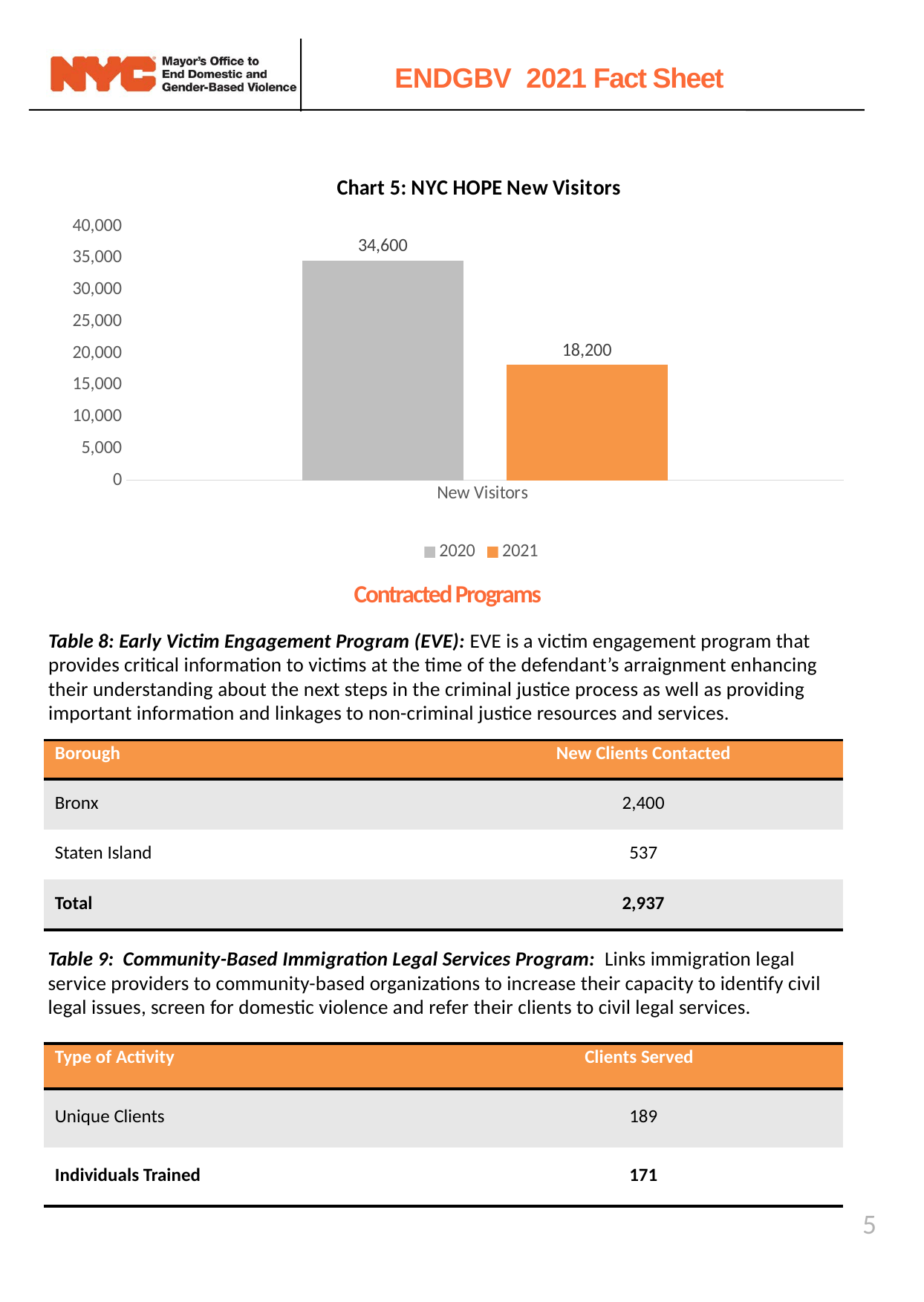
What is the value for 2020 in the New Visitors chart? 34,600 Is the 2021 value larger or smaller than the 2020 value? smaller Which year has the lower number of new visitors? 2021 What colour is the bar for 2021? orange What is the value for 2021 in the New Visitors chart? 18,200 Which year has the higher number of new visitors? 2020 Is the value for 2021 greater or less than 20,000? less What is the difference between the 2020 and 2021 new visitor values? 16,400 What kind of chart is shown? bar chart Is the value for 2020 greater or less than 30,000? greater What is the title of the chart? Chart 5: NYC HOPE New Visitors How many series does the legend list? 2